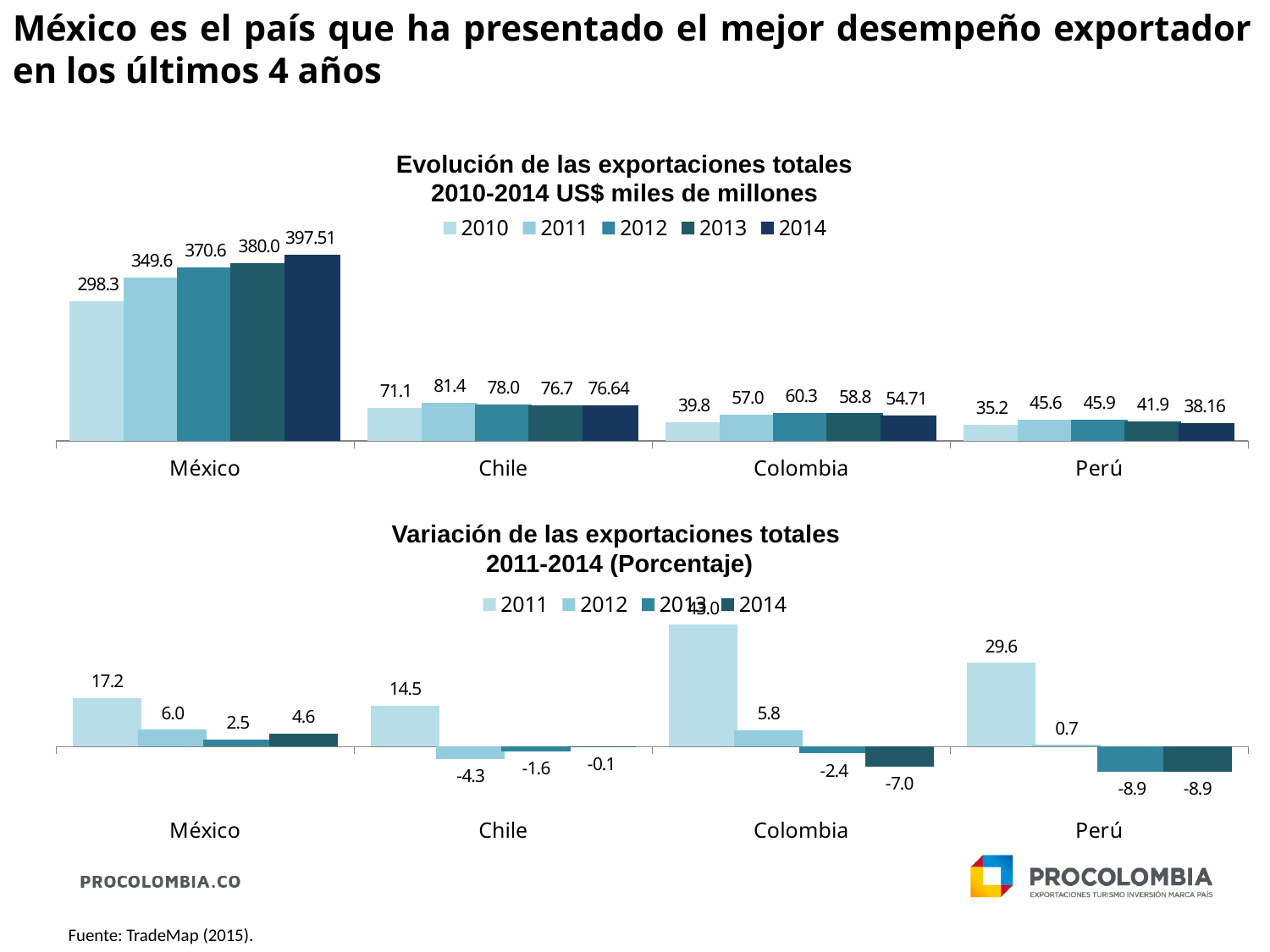
What type of chart is the chart titled 'Variación de las exportaciones totales'? Bar chart In the chart titled 'Evolución de las exportaciones totales', which country has the highest value in 2010? México In the chart titled 'Evolución de las exportaciones totales', what is the value for Chile in 2011? 81.4 In the chart titled 'Variación de las exportaciones totales', what is the value for Perú in 2011? 29.6 In the chart titled 'Evolución de las exportaciones totales', what is the value for México in 2014? 397.51 In the chart titled 'Evolución de las exportaciones totales', which country has the lowest value in 2014? Perú In the chart titled 'Variación de las exportaciones totales', which country has the lowest value in 2014? Perú In the chart titled 'Evolución de las exportaciones totales', how many series does the legend list? 5 In the chart titled 'Variación de las exportaciones totales', how many countries are shown on the x axis? 4 In the chart titled 'Evolución de las exportaciones totales', what is the difference between México's 2014 value and its 2010 value? 99.21 In the chart titled 'Variación de las exportaciones totales', what is the value for Colombia in 2014? -7.0 In the chart titled 'Evolución de las exportaciones totales', is the 2012 value for Colombia larger or smaller than the 2012 value for Perú? larger